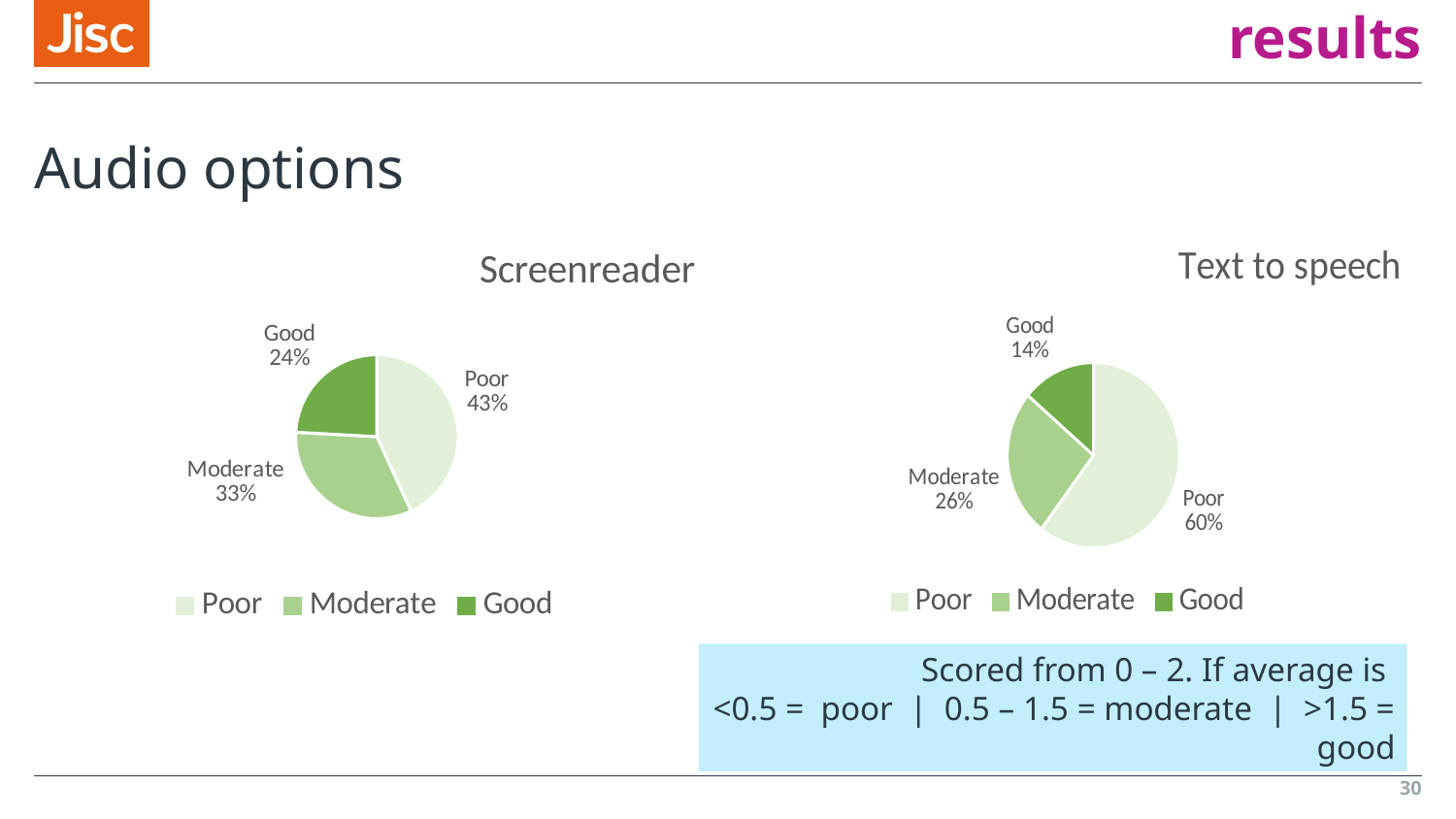
In the Text to speech pie chart, what percentage is labelled Good? 14% What share of the Text to speech pie is labelled Moderate? 26% In the Screenreader pie chart, which category has the smallest share? Good Which chart has the larger Moderate share, Screenreader or Text to speech? Screenreader How many slices does the Text to speech pie chart have? 3 In the Text to speech pie chart, which category has the largest share? Poor What are the three legend entries shown under the Screenreader chart? Poor, Moderate, Good What type of chart is the Screenreader chart? Pie chart In the Text to speech pie chart, what is the difference between the Poor and Moderate percentages? 34% In the Screenreader pie chart, what is the difference between the Poor and Good percentages? 19% In the Screenreader pie chart, what percentage is labelled Moderate? 33% In the Screenreader pie chart, what percentage is labelled Poor? 43%